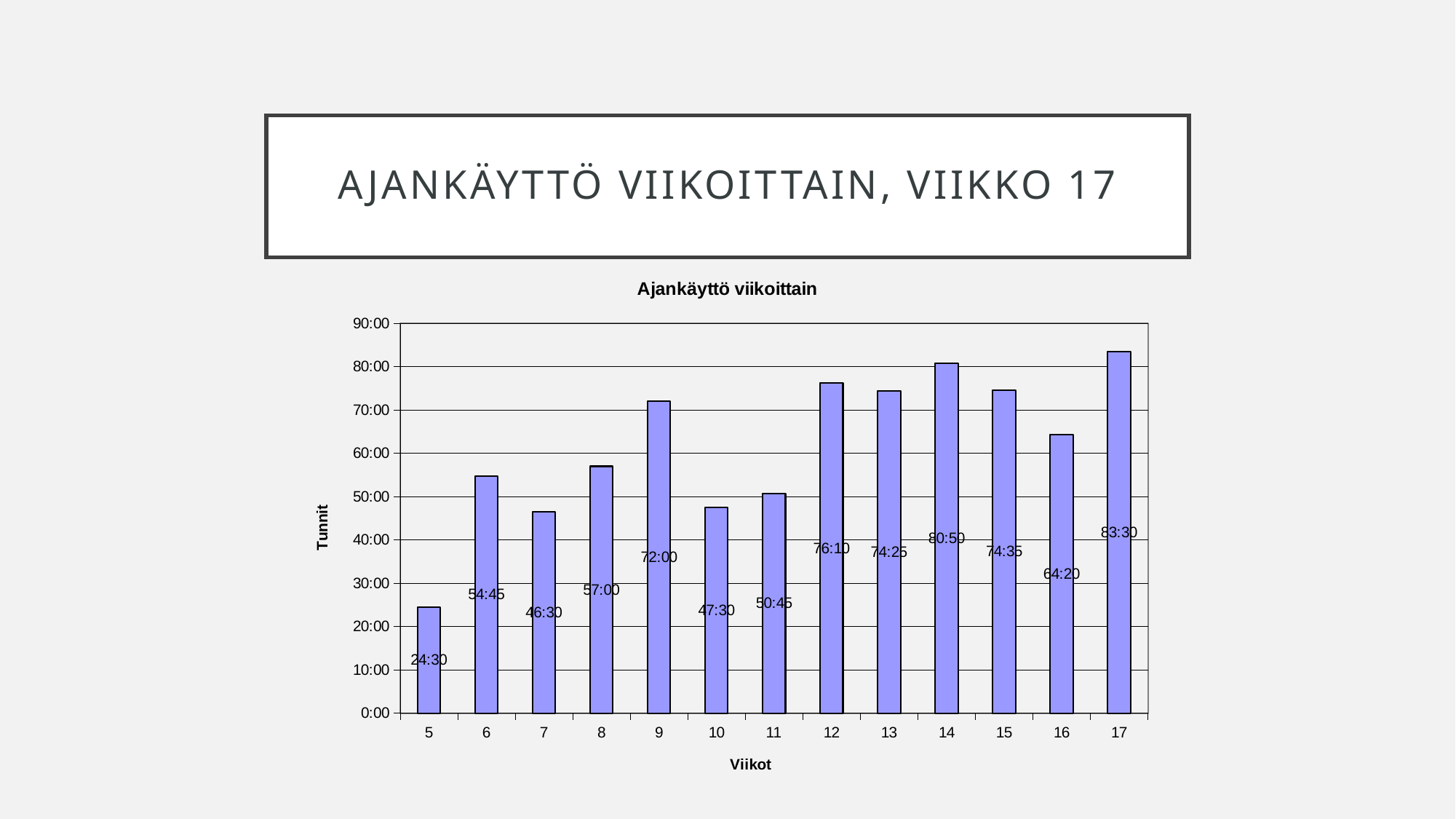
What is the difference between the values for week 17 and week 5? 59:00 Is the value for week 7 greater or less than 50:00? less Which week has the highest value? 17 What is the chart's title? Ajankäyttö viikoittain Which is larger, the value for week 9 or the value for week 10? week 9 What is the difference between the values for week 9 and week 8? 15:00 What is the value for week 5? 24:30 What is the value for week 12? 76:10 What is the value for week 16? 64:20 Which week has the lowest value? 5 What kind of chart is shown on the slide? bar chart How many weeks are plotted on the x axis? 13